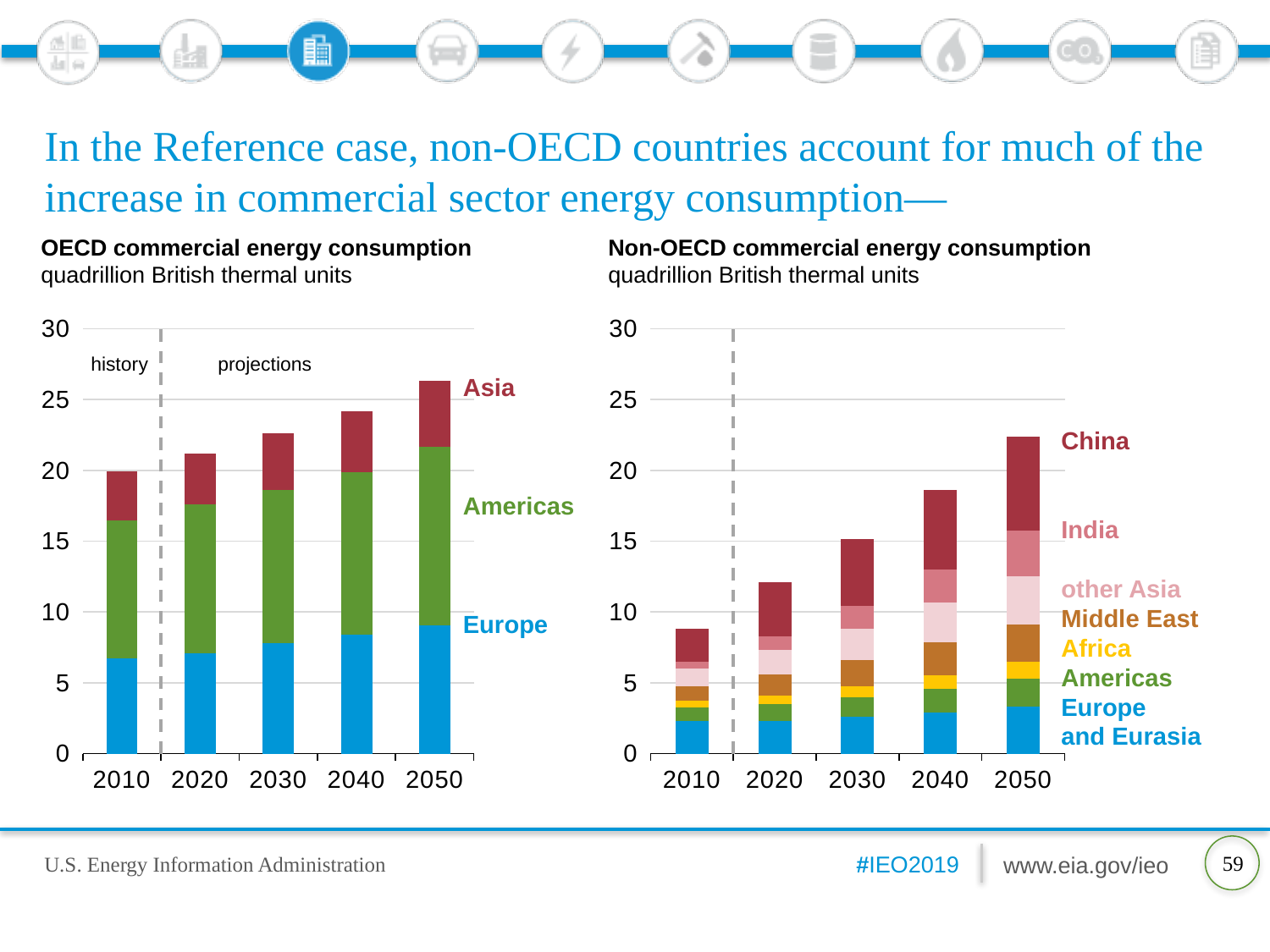
In the Non-OECD commercial energy consumption chart, which year has the lowest total bar? 2010 What unit is used on both charts? quadrillion British thermal units In the OECD commercial energy consumption chart, do total values rise or fall from 2010 to 2050? rise Which chart has the larger total bar for 2050, the OECD chart or the Non-OECD chart? OECD How many regions are stacked in the Non-OECD commercial energy consumption chart? 7 In the Non-OECD commercial energy consumption chart, is the total for 2010 greater or less than 10? less How many regions are stacked in the OECD commercial energy consumption chart? 3 What kind of chart is the OECD commercial energy consumption chart? stacked bar chart In the Non-OECD commercial energy consumption chart, which year has the highest total bar? 2050 In the Non-OECD commercial energy consumption chart, is the total for 2050 greater or less than 20? greater In the OECD commercial energy consumption chart, is the total for 2050 greater or less than 25? greater How many years are shown on the x axis of the Non-OECD commercial energy consumption chart? 5